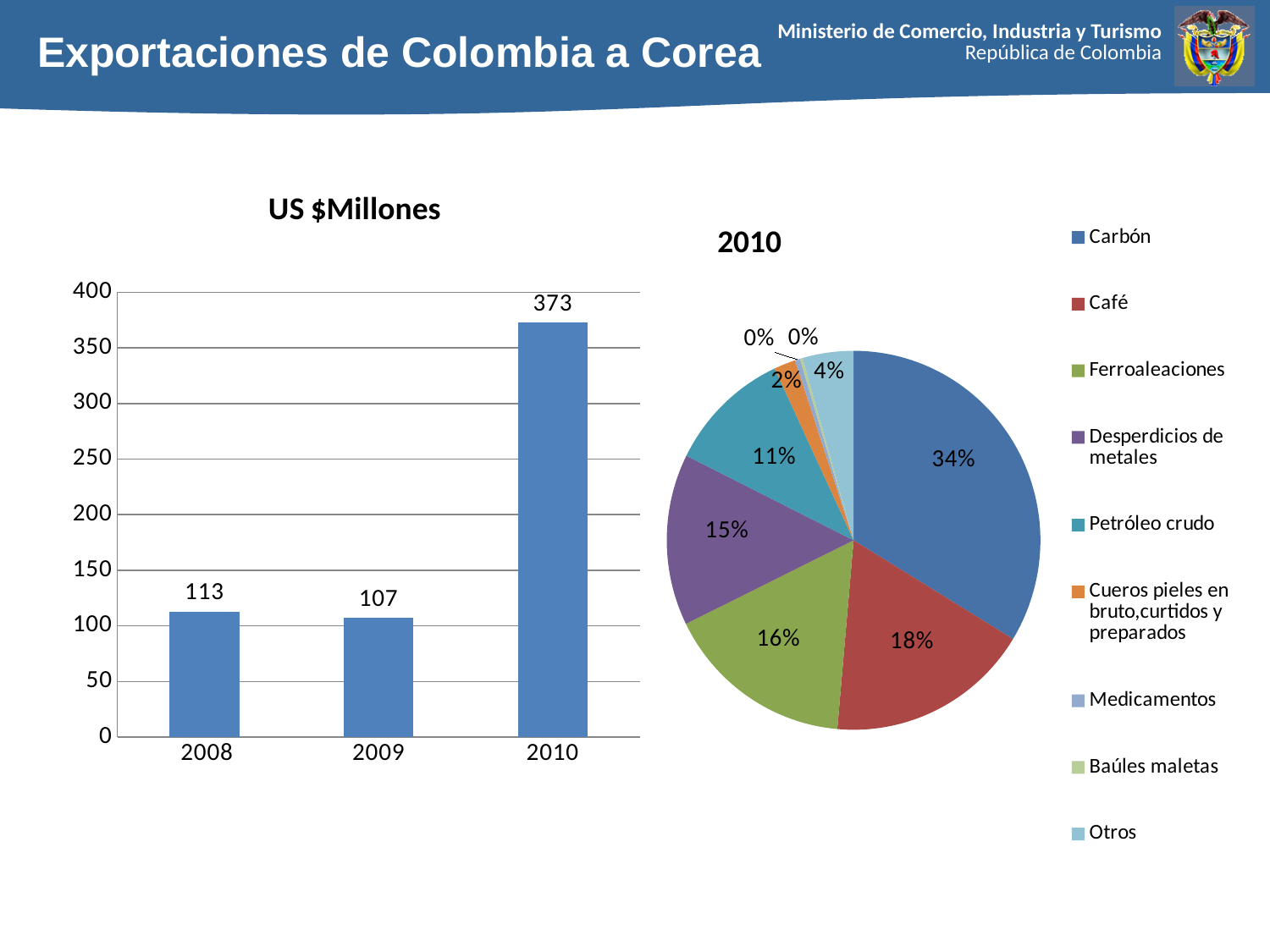
In the 'US $Millones' bar chart, which year has the lowest value? 2009 In the '2010' pie chart, what share does Café have? 18% How many entries does the legend of the '2010' pie chart list? 9 In the 'US $Millones' bar chart, what is the difference between the values for 2010 and 2009? 266 In the 'US $Millones' bar chart, which year has the highest value? 2010 In the '2010' pie chart, what share does Carbón have? 34% In the 'US $Millones' bar chart, what is the value for 2008? 113 In the 'US $Millones' bar chart, how many years are shown? 3 In the '2010' pie chart, which is larger: Ferroaleaciones or Petróleo crudo? Ferroaleaciones What kind of chart is the 'US $Millones' chart on the left? Bar chart In the '2010' pie chart, which category has the largest share? Carbón In the 'US $Millones' bar chart, what is the value for 2010? 373